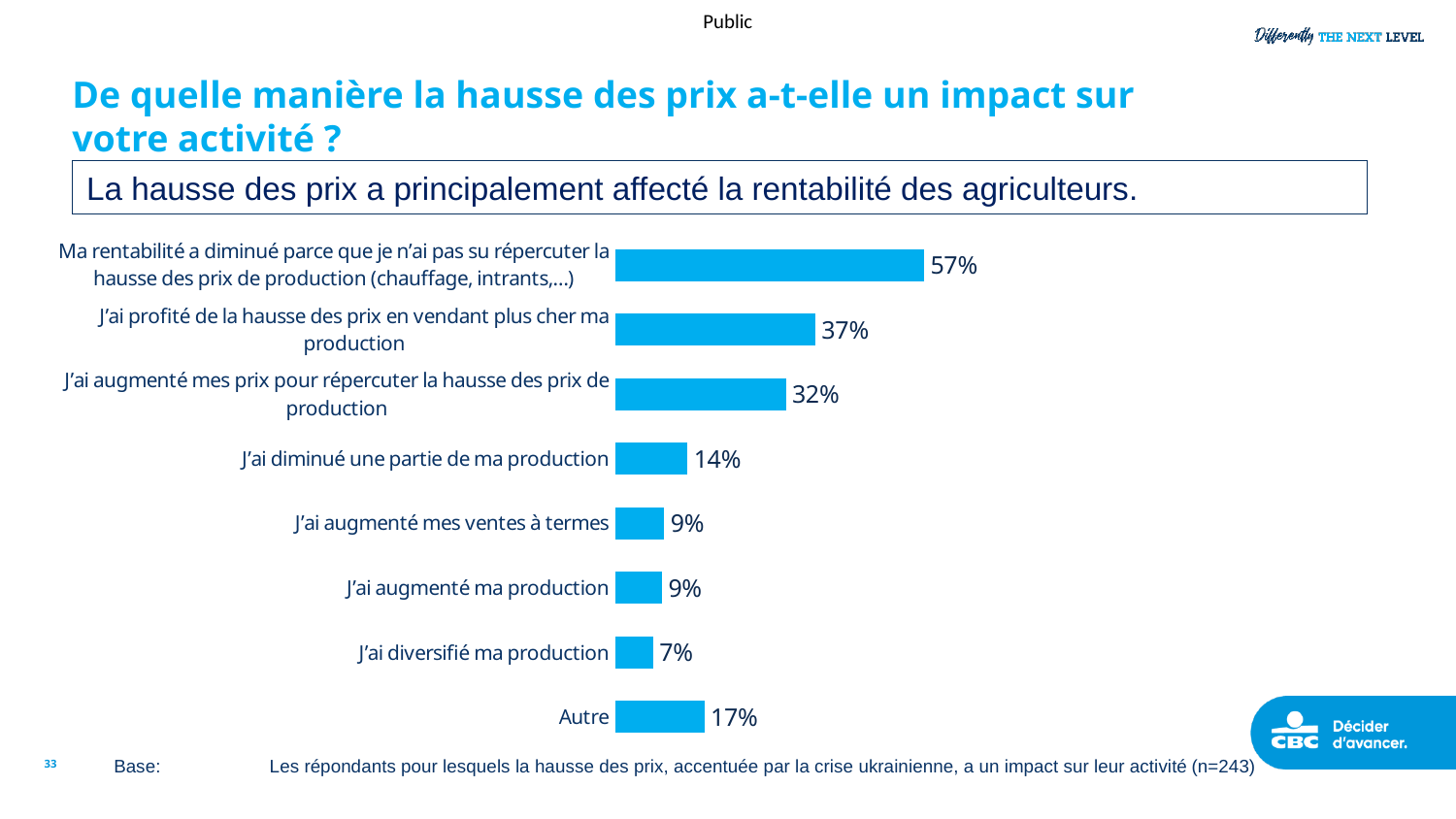
What is the difference between the values for "Ma rentabilité a diminué..." (57%) and "J'ai augmenté mes prix pour répercuter la hausse des prix de production"? 25% What kind of chart is shown on the slide? Bar chart What is the difference between the values for "Autre" and "J'ai diversifié ma production"? 10% Which category has the lowest value? J'ai diversifié ma production Which is larger: the value for "J'ai profité de la hausse des prix en vendant plus cher ma production" or for "J'ai augmenté mes prix pour répercuter la hausse des prix de production"? J'ai profité de la hausse des prix en vendant plus cher ma production Which two categories share the same value of 9%? J'ai augmenté mes ventes à termes; J'ai augmenté ma production Which category has the highest value? Ma rentabilité a diminué parce que je n'ai pas su répercuter la hausse des prix de production (chauffage, intrants,…) What is the value for "J'ai diminué une partie de ma production"? 14% What is the value for "J'ai profité de la hausse des prix en vendant plus cher ma production"? 37% What is the value for "Autre"? 17% What is the sample size (n) stated in the base note below the chart? n=243 How many categories are shown in the chart? 8